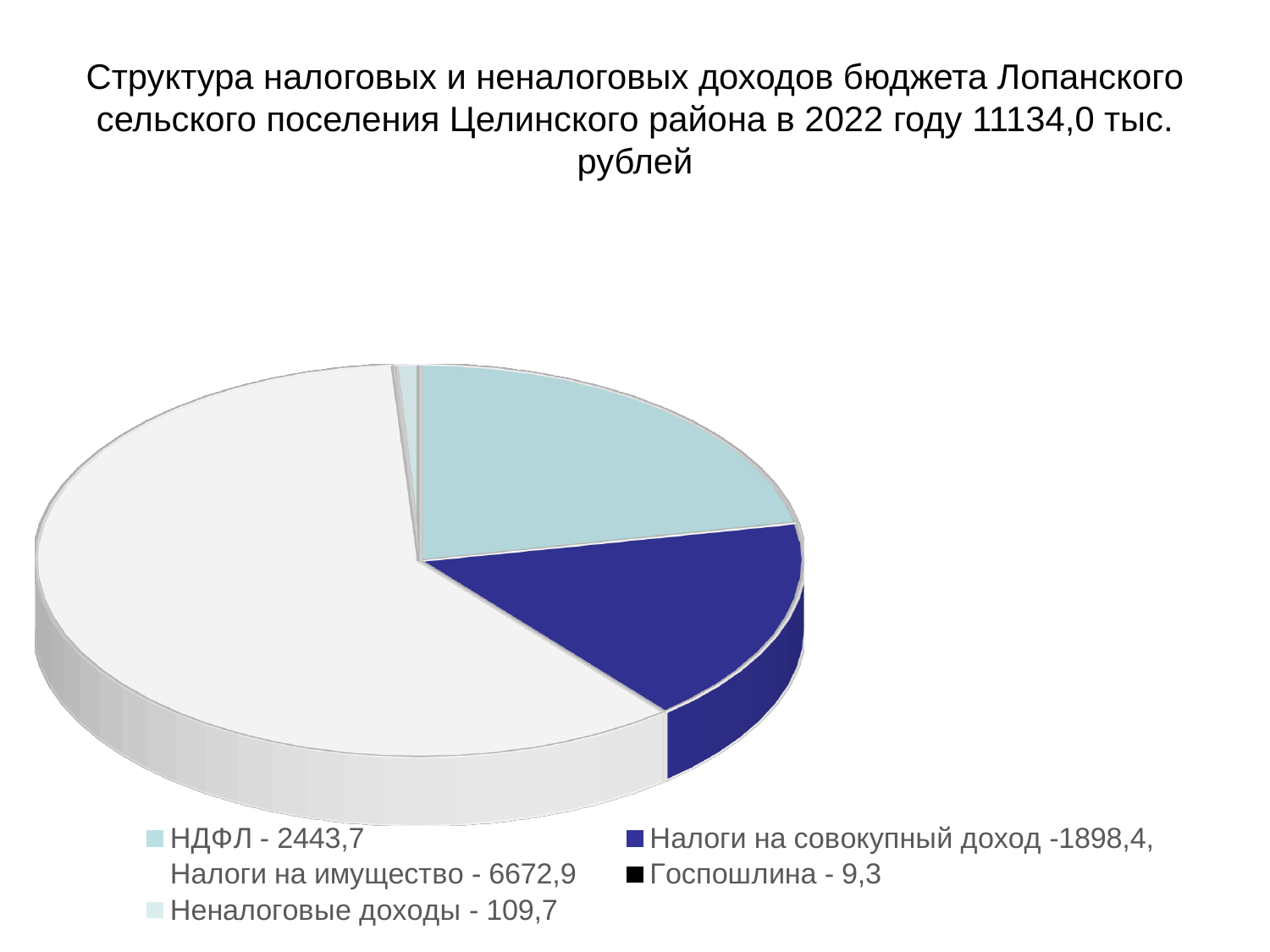
What is the value for Неналоговые доходы? 109,7 What is the value for НДФЛ? 2443,7 Which category has the smallest value? Госпошлина Which year does the chart title refer to? 2022 What kind of chart is shown on the slide? pie chart What is the value for Госпошлина? 9,3 Which category has the largest share of the pie? Налоги на имущество What is the total of all categories, as stated in the chart title? 11134,0 тыс. рублей What is the value for Налоги на имущество? 6672,9 How many categories does the pie chart have? 5 What is the difference between Налоги на имущество and НДФЛ? 4229,2 Which is larger, НДФЛ or Налоги на совокупный доход? НДФЛ